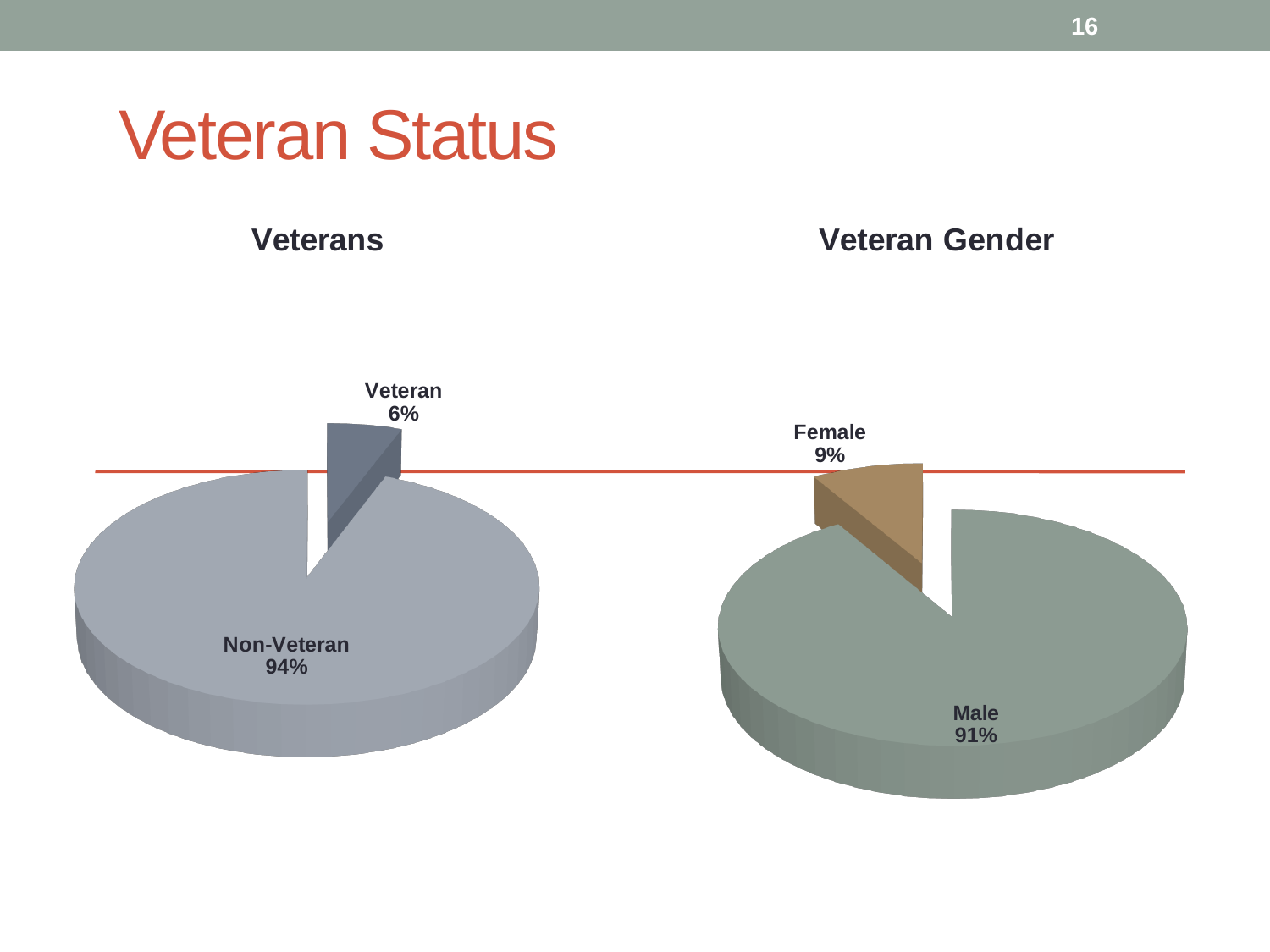
In the Veteran Gender chart, which slice is the smallest? Female In the Veterans chart, what is the difference in percentage points between Non-Veteran and Veteran? 88 In the Veteran Gender chart, what percentage is labelled Female? 9% In the Veterans chart, what percentage is labelled Veteran? 6% Which is larger: the Veteran share in the Veterans chart or the Female share in the Veteran Gender chart? Female In the Veteran Gender chart, what percentage is labelled Male? 91% In the Veteran Gender chart, what is the difference in percentage points between Male and Female? 82 What is the title of the chart on the right side of the slide? Veteran Gender How many slices does the Veterans chart have? 2 In the Veterans chart, what percentage is labelled Non-Veteran? 94% What kind of chart is the Veteran Gender chart? Pie chart In the Veterans chart, which slice is the largest? Non-Veteran